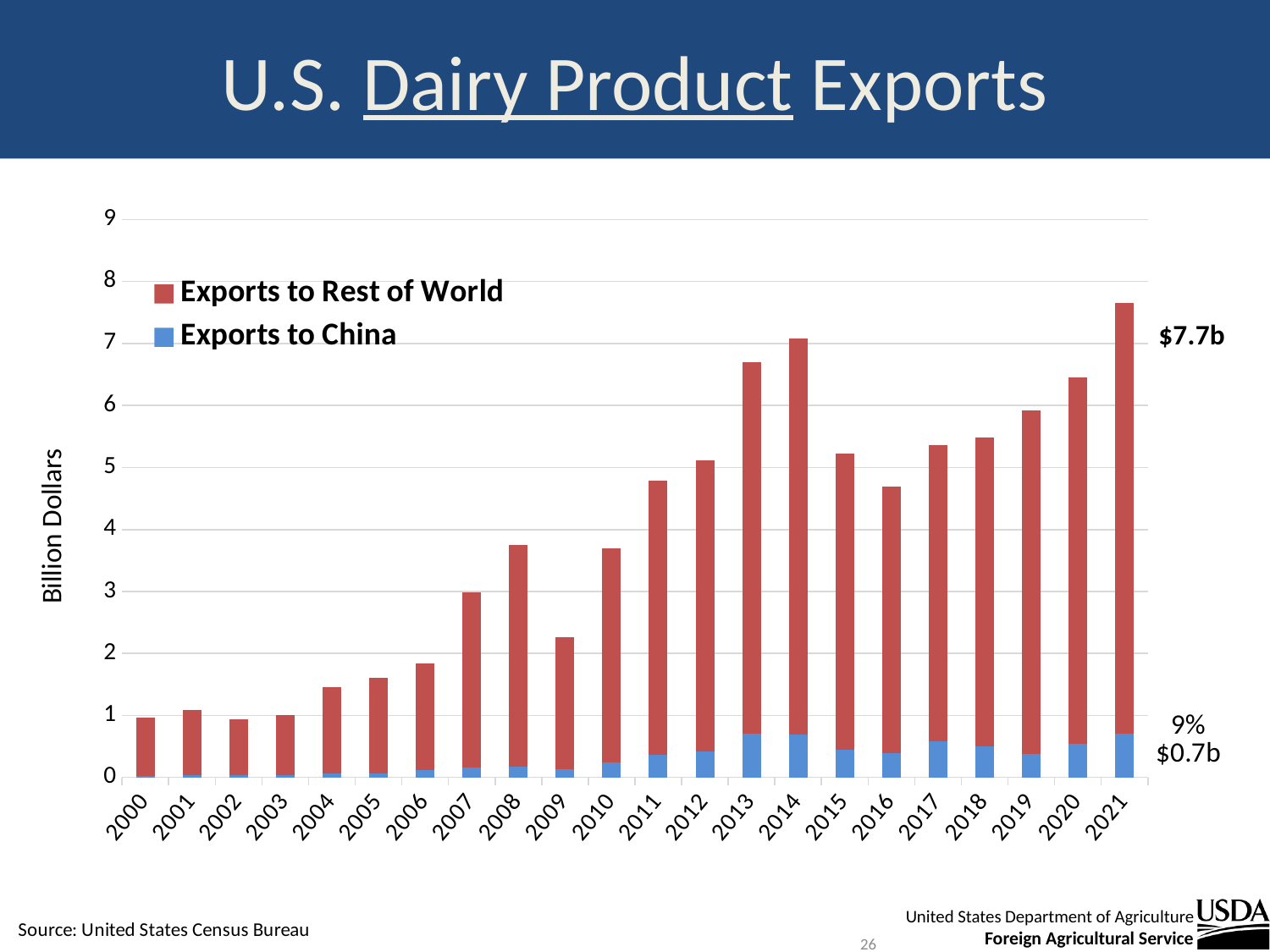
How many years are shown along the x axis? 22 What share of 2021 dairy product exports went to China, according to the label on the chart? 9% What is the value of exports to China in 2021 as labeled on the chart? $0.7b What kind of chart is shown on the slide? bar chart What is the total value of U.S. dairy product exports in 2021 as labeled on the chart? $7.7b Is the total value for 2009 greater or less than 3? less Which year has the highest total dairy product exports? 2021 What is the label on the y axis? Billion Dollars How many series does the legend list? 2 Do total dairy product exports generally rise or fall from 2000 to 2021? rise Is the total value for 2013 greater or less than 6? greater Which year has larger total exports, 2014 or 2015? 2014